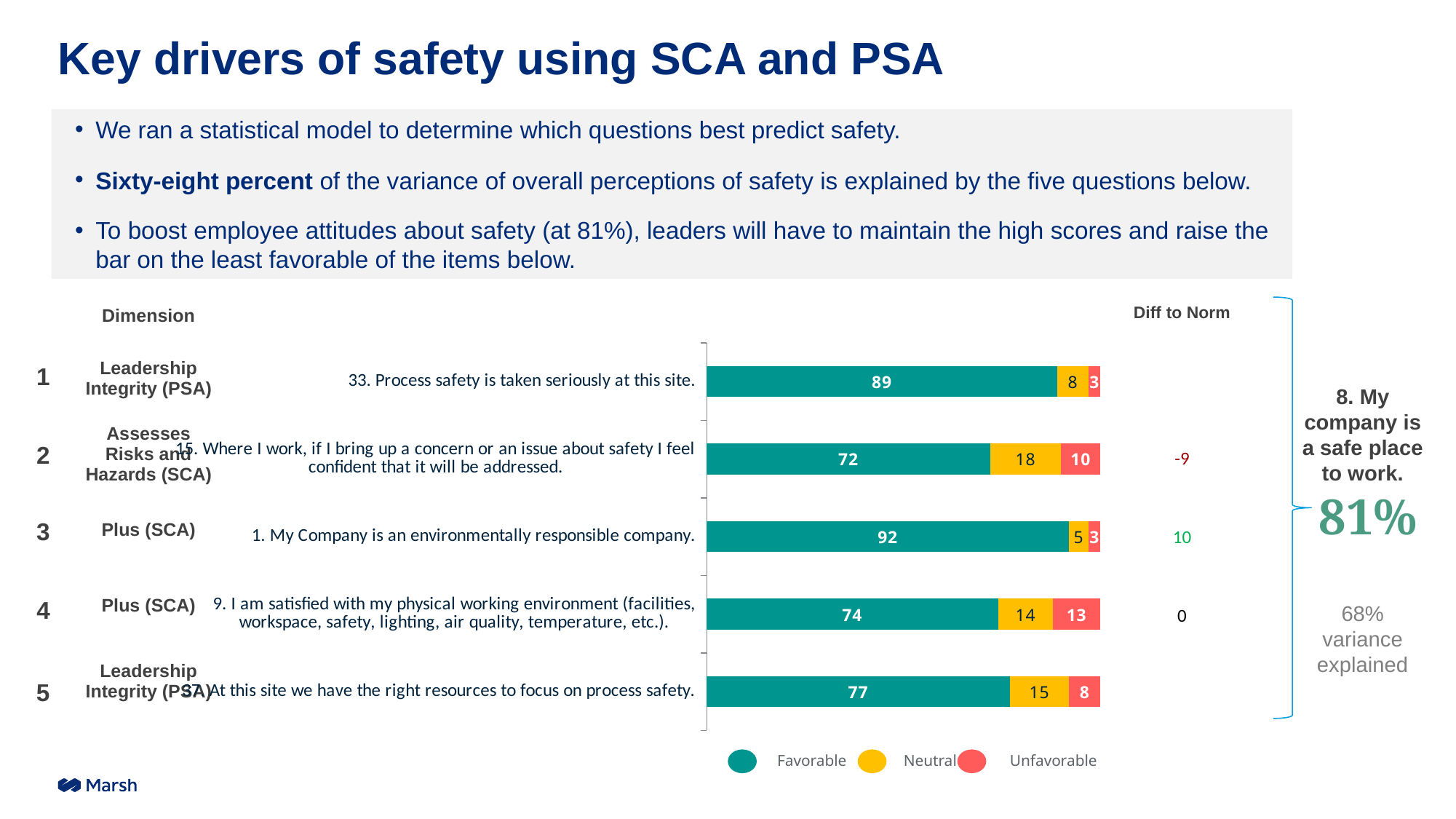
What is the total of the stacked bar for item 9, 'I am satisfied with my physical working environment'? 101 How many survey items (bars) are plotted in the chart? 5 How many series does the chart legend list? 3 What is the Favorable value for item 33, 'Process safety is taken seriously at this site'? 89 What is the difference between the Favorable values for item 1 (environmentally responsible company) and item 37 (right resources to focus on process safety)? 15 Which item has the highest Favorable value? 1. My Company is an environmentally responsible company. What is the Unfavorable value for item 9, 'I am satisfied with my physical working environment'? 13 Which has a larger Unfavorable value: item 15 (concern about safety will be addressed) or item 37 (right resources to focus on process safety)? Item 15 Which legend entry is represented by the teal colour in the chart? Favorable What is the Neutral value for item 15, 'Where I work, if I bring up a concern or an issue about safety I feel confident that it will be addressed'? 18 What type of chart is shown on the slide? Stacked bar chart Which item has the lowest Favorable value? 15. Where I work, if I bring up a concern or an issue about safety I feel confident that it will be addressed.